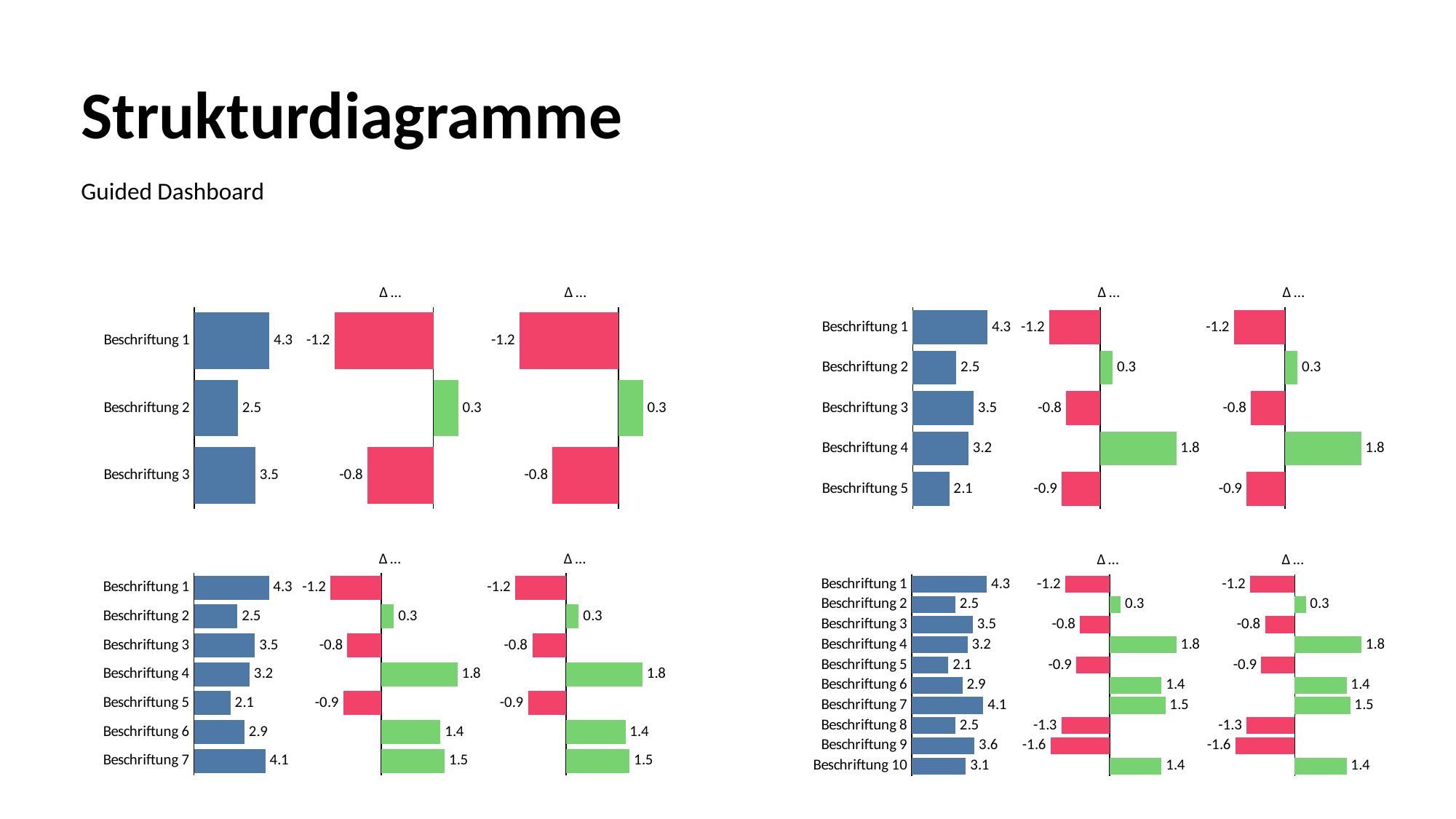
In the bottom-right chart, what is the first delta value for Beschriftung 9? -1.6 In the top-left chart, what is the value of the blue bar for Beschriftung 1? 4.3 In the top-left chart, which category has the lowest blue bar value? Beschriftung 2 In the bottom-right chart, which is larger: the blue bar value for Beschriftung 7 or for Beschriftung 10? Beschriftung 7 How many categories are shown in the top-right chart? 5 In the top-right chart, what is the first delta value for Beschriftung 4? 1.8 In the top-right chart, which category has the highest blue bar value? Beschriftung 1 In the bottom-left chart, what is the blue bar value for Beschriftung 7? 4.1 What type of chart is used in the bottom-right group? Bar chart How many categories are shown in the top-left chart? 3 How many categories are shown in the bottom-right chart? 10 In the bottom-left chart, what is the difference between the blue bar values of Beschriftung 1 and Beschriftung 5? 2.2